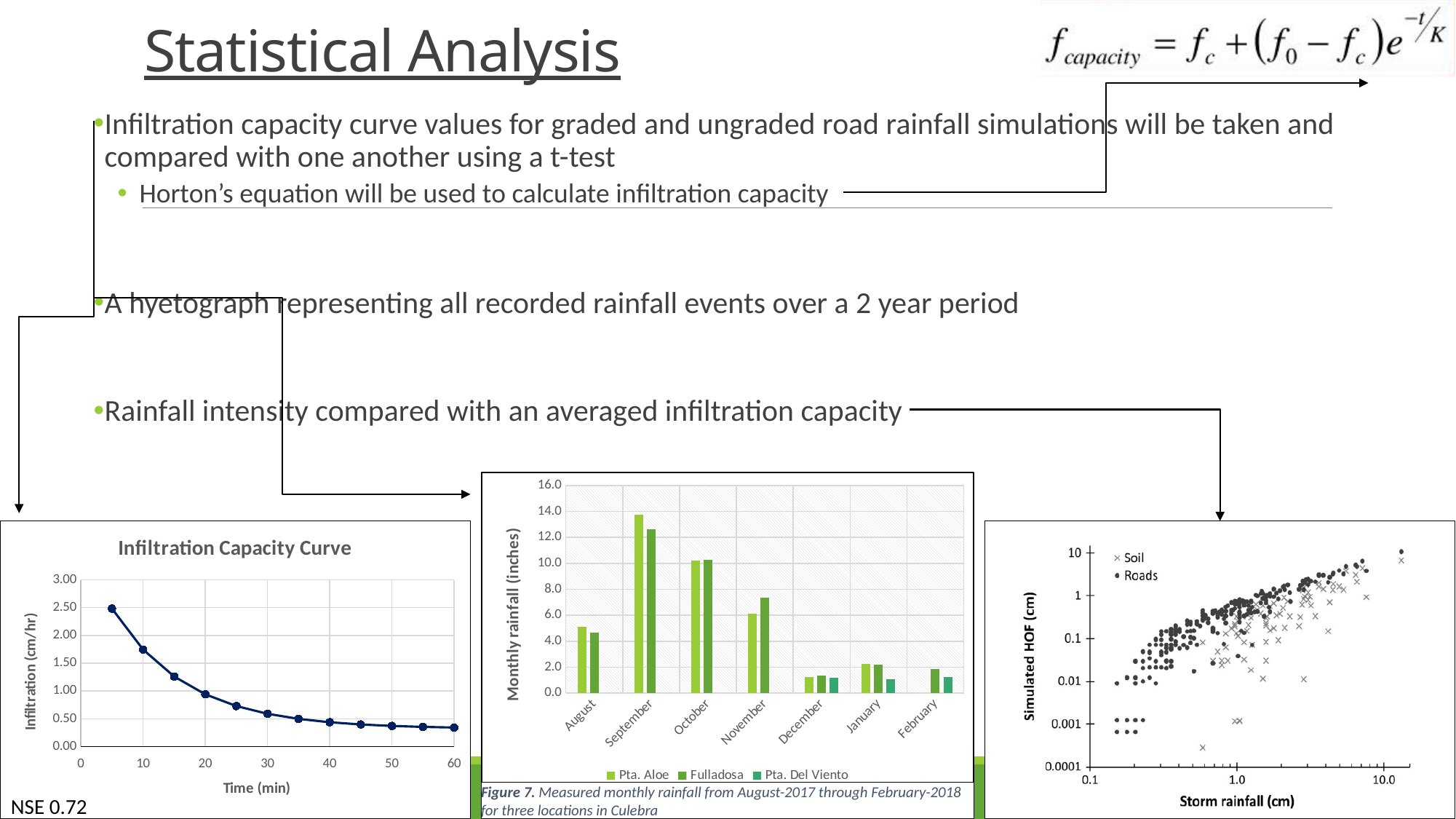
What kind of chart is the Infiltration Capacity Curve chart? line chart In the Infiltration Capacity Curve chart, is the infiltration value at 60 minutes greater or less than 0.50 cm/hr? less How many data points are plotted in the Infiltration Capacity Curve chart? 12 In the monthly rainfall chart (Figure 7), which is larger for November: Pta. Aloe or Fulladosa? Fulladosa What kind of chart is the monthly rainfall chart (Figure 7)? bar chart What is the x-axis label of the scatter plot on the right? Storm rainfall (cm) In the Infiltration Capacity Curve chart, do the values rise or fall as time increases? fall How many series does the legend of the scatter plot on the right list? 2 How many series does the legend of the monthly rainfall chart (Figure 7) list? 3 In the monthly rainfall chart (Figure 7), is the Pta. Aloe value for September greater or less than 12.0 inches? greater In the Infiltration Capacity Curve chart, is the infiltration value at 5 minutes greater or less than 2.00 cm/hr? greater In the monthly rainfall chart (Figure 7), which month has the highest rainfall? September